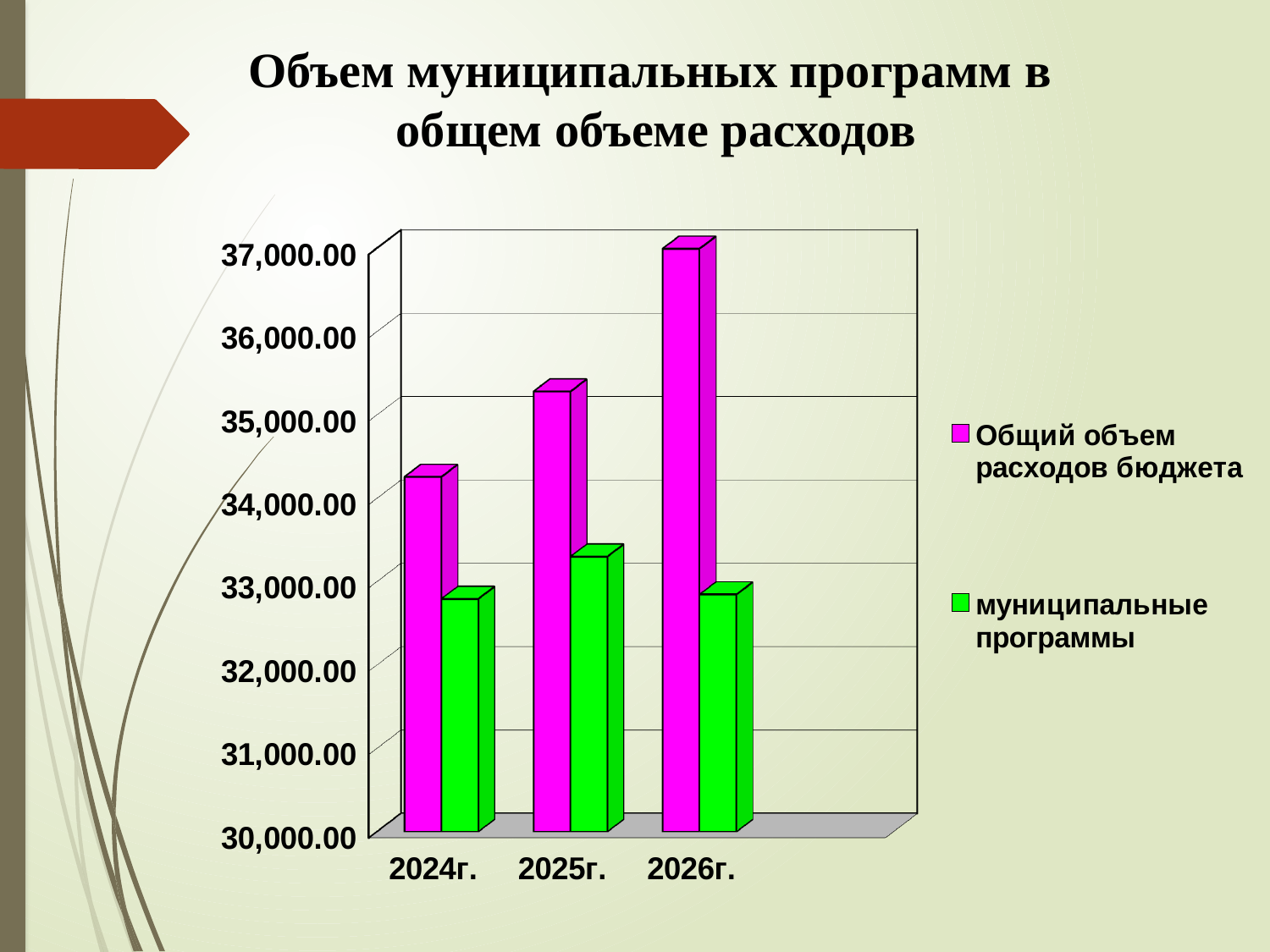
Which year has the lowest value for Общий объем расходов бюджета? 2024г. How many years are shown on the x axis? 3 Which is larger: Общий объем расходов бюджета in 2025г. or in 2024г.? 2025г. Do the values for Общий объем расходов бюджета rise or fall from 2024г. to 2026г.? rise What colour are the bars for муниципальные программы? green What kind of chart is shown on the slide? bar chart Is the value for Общий объем расходов бюджета in 2026г. greater or less than 36,000.00? greater Is the value for Общий объем расходов бюджета in 2024г. greater or less than 35,000.00? less How many series does the legend list? 2 Which year has the highest value for муниципальные программы? 2025г. Which year has the highest value for Общий объем расходов бюджета? 2026г.